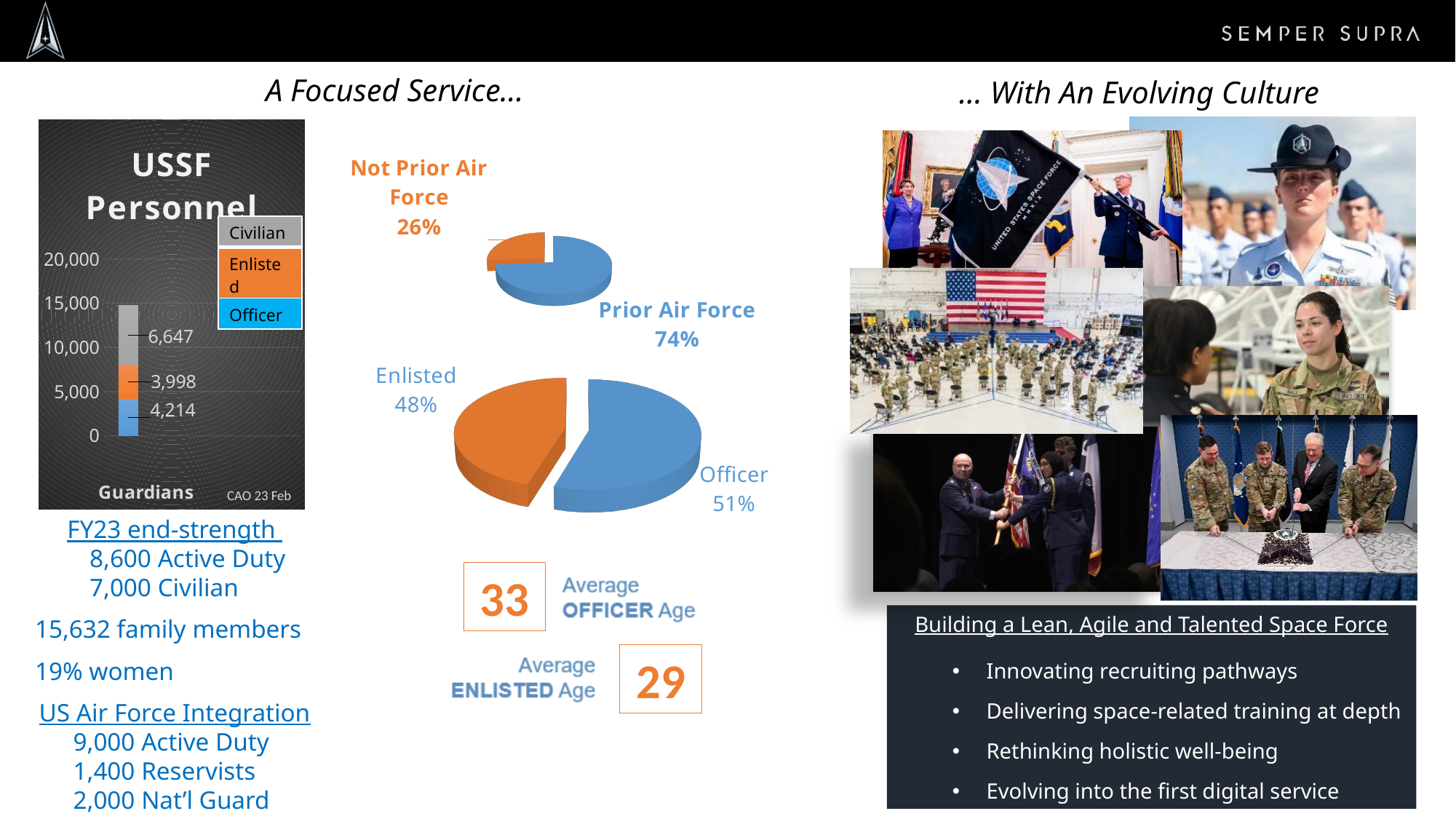
In the USSF Personnel bar chart, what is the difference between the Civilian and Officer values? 2,433 In the USSF Personnel bar chart, what is the value for Enlisted? 3,998 In the upper pie chart, what share is Prior Air Force? 74% In the lower pie chart, which slice is larger, Enlisted or Officer? Officer In the upper pie chart, what share is Not Prior Air Force? 26% How many series does the legend of the USSF Personnel bar chart list? 3 What type of chart is the USSF Personnel chart? Stacked bar chart In the USSF Personnel bar chart, which segment has the smallest value? Enlisted In the USSF Personnel bar chart, what is the total of the stacked Guardians bar? 14,859 In the USSF Personnel bar chart, what is the value for Officer? 4,214 In the USSF Personnel bar chart, what is the value for Civilian? 6,647 In the USSF Personnel bar chart, which segment has the largest value? Civilian